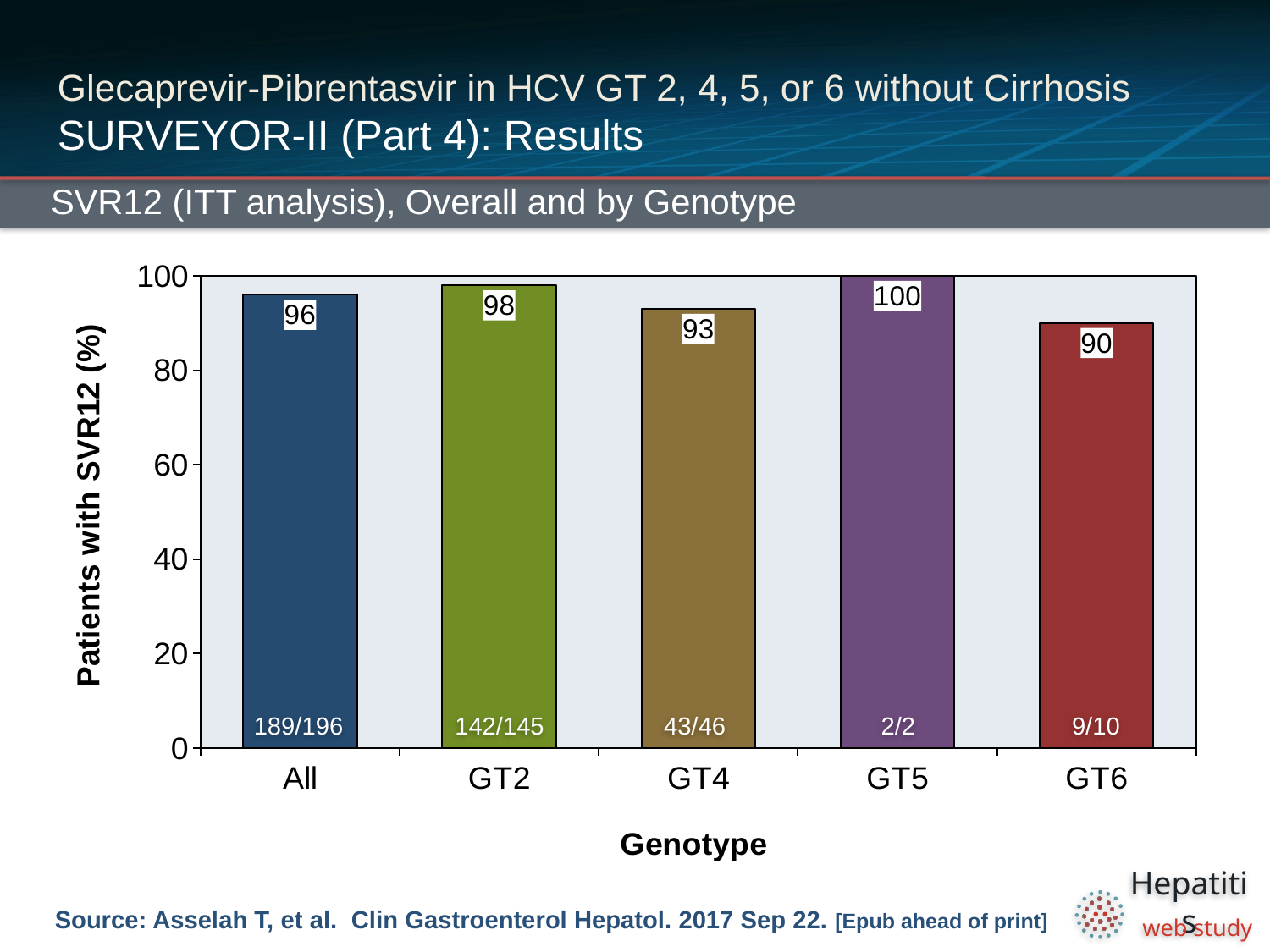
What is the difference in SVR12 rate between GT5 and GT6? 10 How many bars are shown in the chart? 5 Which has a higher SVR12 rate, GT2 or GT4? GT2 What is the SVR12 rate for the All group? 96 What type of chart is shown on the slide? Bar chart What fraction of patients is shown inside the GT4 bar? 43/46 Which genotype has the lowest SVR12 rate? GT6 Which genotype has the highest SVR12 rate? GT5 What is the label of the x-axis? Genotype What is the SVR12 rate for GT2? 98 What is the SVR12 rate for GT6? 90 What is the label of the y-axis? Patients with SVR12 (%)